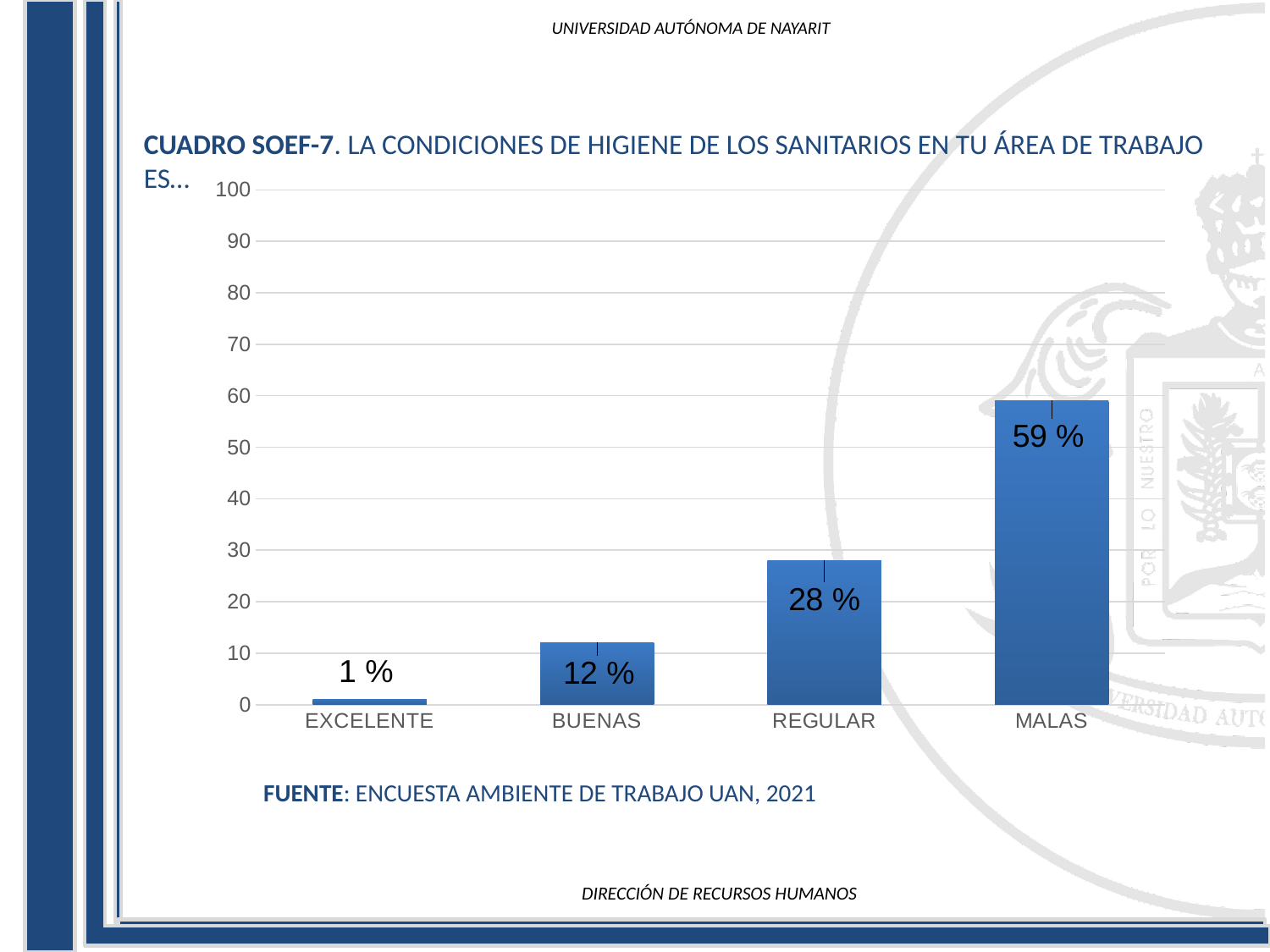
Which is larger, the value for BUENAS or the value for REGULAR? REGULAR What is the difference between the values for MALAS and REGULAR? 31 % Is the value for MALAS greater or less than 50? greater What kind of chart is shown on the slide? bar chart What is the value for MALAS? 59 % Which category has the highest value? MALAS What is the value for BUENAS? 12 % What is the value for REGULAR? 28 % What is the value for EXCELENTE? 1 % How many categories are shown on the x axis? 4 Which category has the lowest value? EXCELENTE What source is cited below the chart? ENCUESTA AMBIENTE DE TRABAJO UAN, 2021